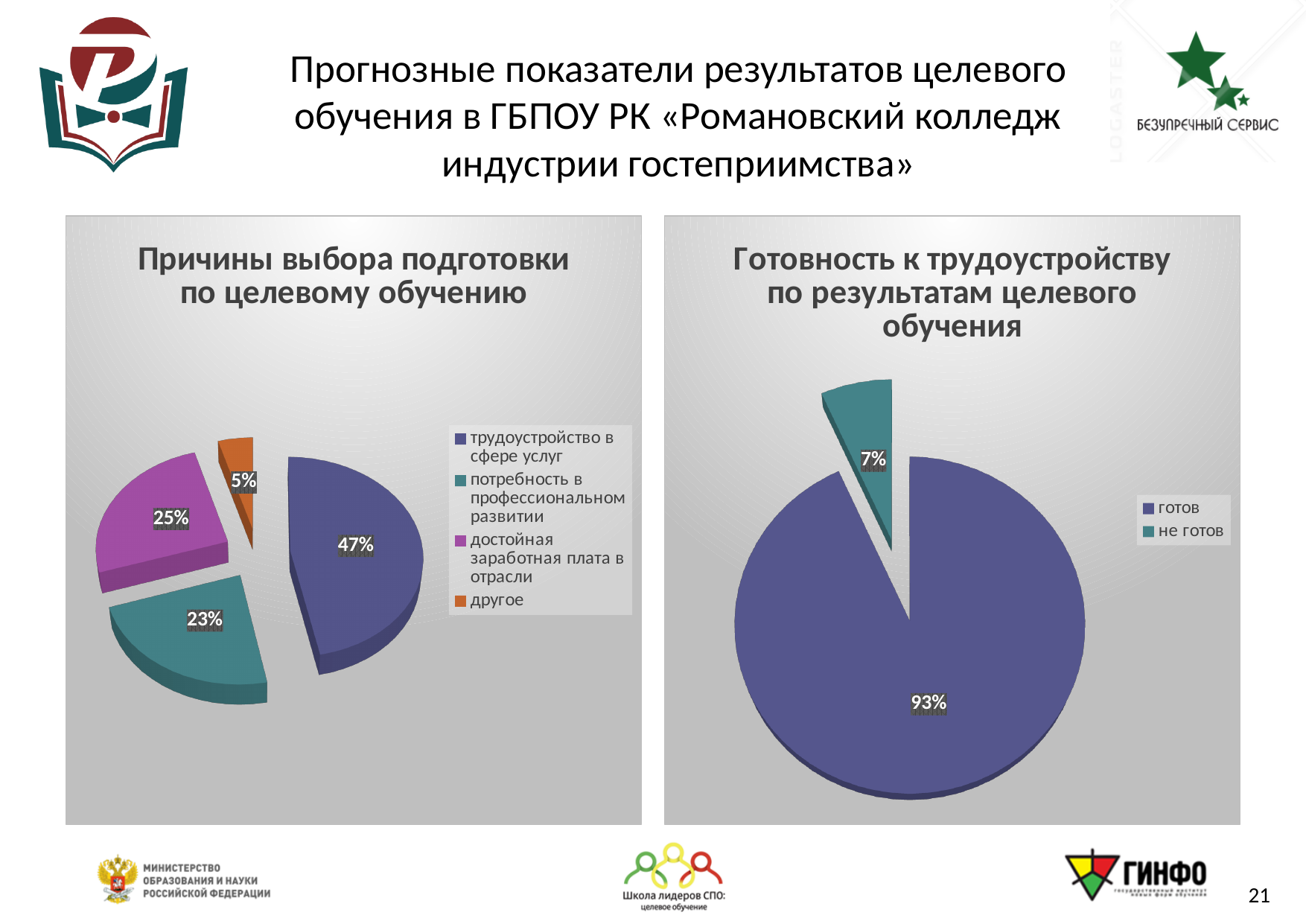
In the chart titled «Причины выбора подготовки по целевому обучению», which is larger: «достойная заработная плата в отрасли» or «потребность в профессиональном развитии»? достойная заработная плата в отрасли What type of chart is the one titled «Готовность к трудоустройству по результатам целевого обучения»? Pie chart In the chart titled «Готовность к трудоустройству по результатам целевого обучения», what share is labelled for «готов»? 93% In the chart titled «Причины выбора подготовки по целевому обучению», which category has the smallest slice? другое In the chart titled «Причины выбора подготовки по целевому обучению», what share is labelled for «потребность в профессиональном развитии»? 23% In the chart titled «Причины выбора подготовки по целевому обучению», what share is labelled for «трудоустройство в сфере услуг»? 47% In the chart titled «Готовность к трудоустройству по результатам целевого обучения», what share is labelled for «не готов»? 7% In the chart titled «Причины выбора подготовки по целевому обучению», how many categories does the legend list? 4 In the chart titled «Готовность к трудоустройству по результатам целевого обучения», how many entries does the legend list? 2 In the chart titled «Причины выбора подготовки по целевому обучению», what share is labelled for «достойная заработная плата в отрасли»? 25% In the chart titled «Причины выбора подготовки по целевому обучению», what is the difference in percentage points between «трудоустройство в сфере услуг» and «другое»? 42 percentage points In the chart titled «Причины выбора подготовки по целевому обучению», which category has the largest slice? трудоустройство в сфере услуг